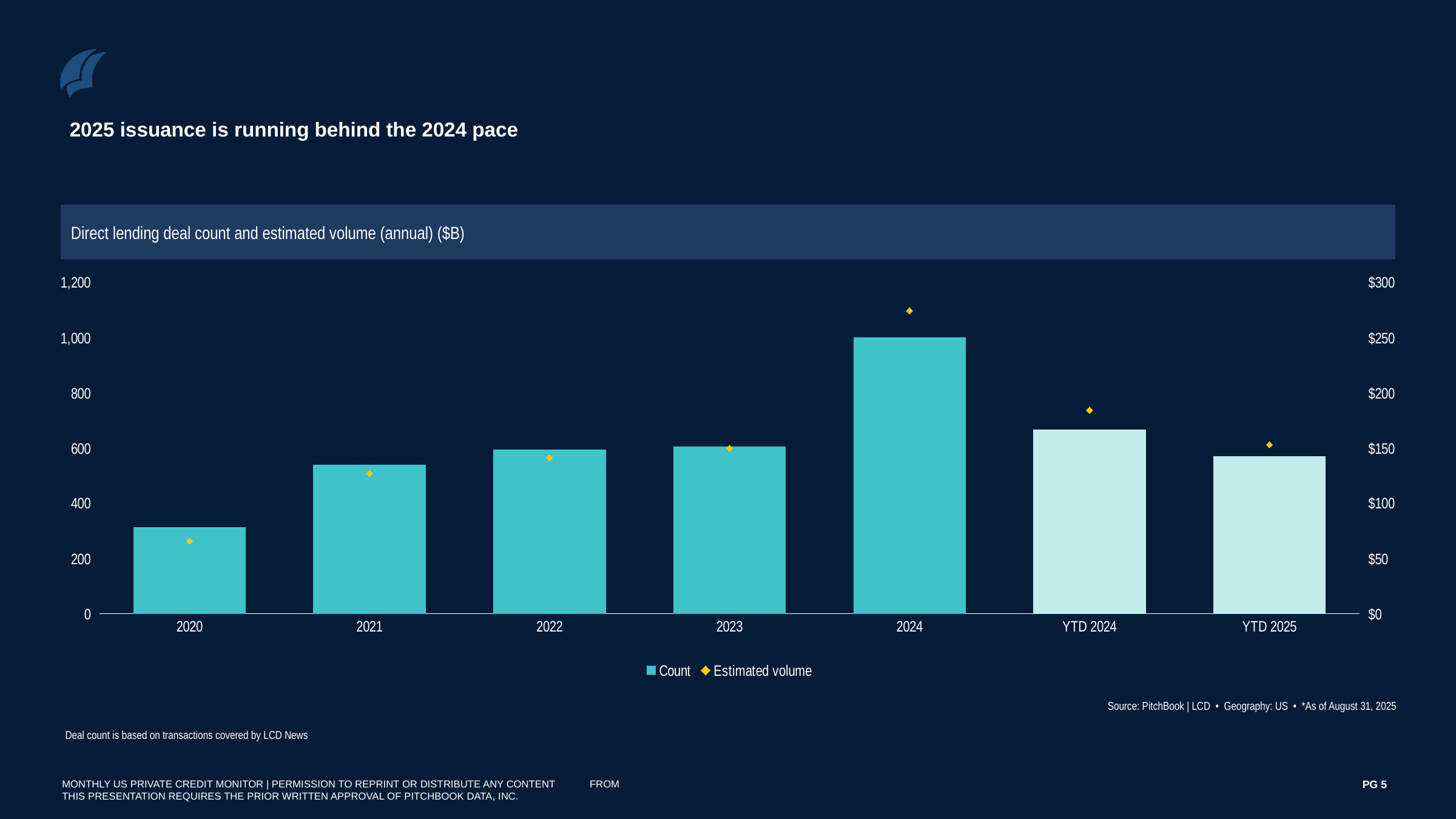
What kind of chart is shown on the slide? Bar chart (with diamond markers for estimated volume) How many categories are shown on the x axis of the chart? 7 How many series does the legend list? 2 Is the deal count for 2020 greater or less than 400? less What is the title of the chart? Direct lending deal count and estimated volume (annual) ($B) Is the deal count for YTD 2024 greater or less than 600? greater Which category has the lowest deal count bar? 2020 Is the estimated volume for 2024 greater or less than $250? greater Which has the larger deal count, YTD 2024 or YTD 2025? YTD 2024 Which year has the highest deal count bar? 2024 Do the deal count bars rise or fall from 2020 to 2024? rise